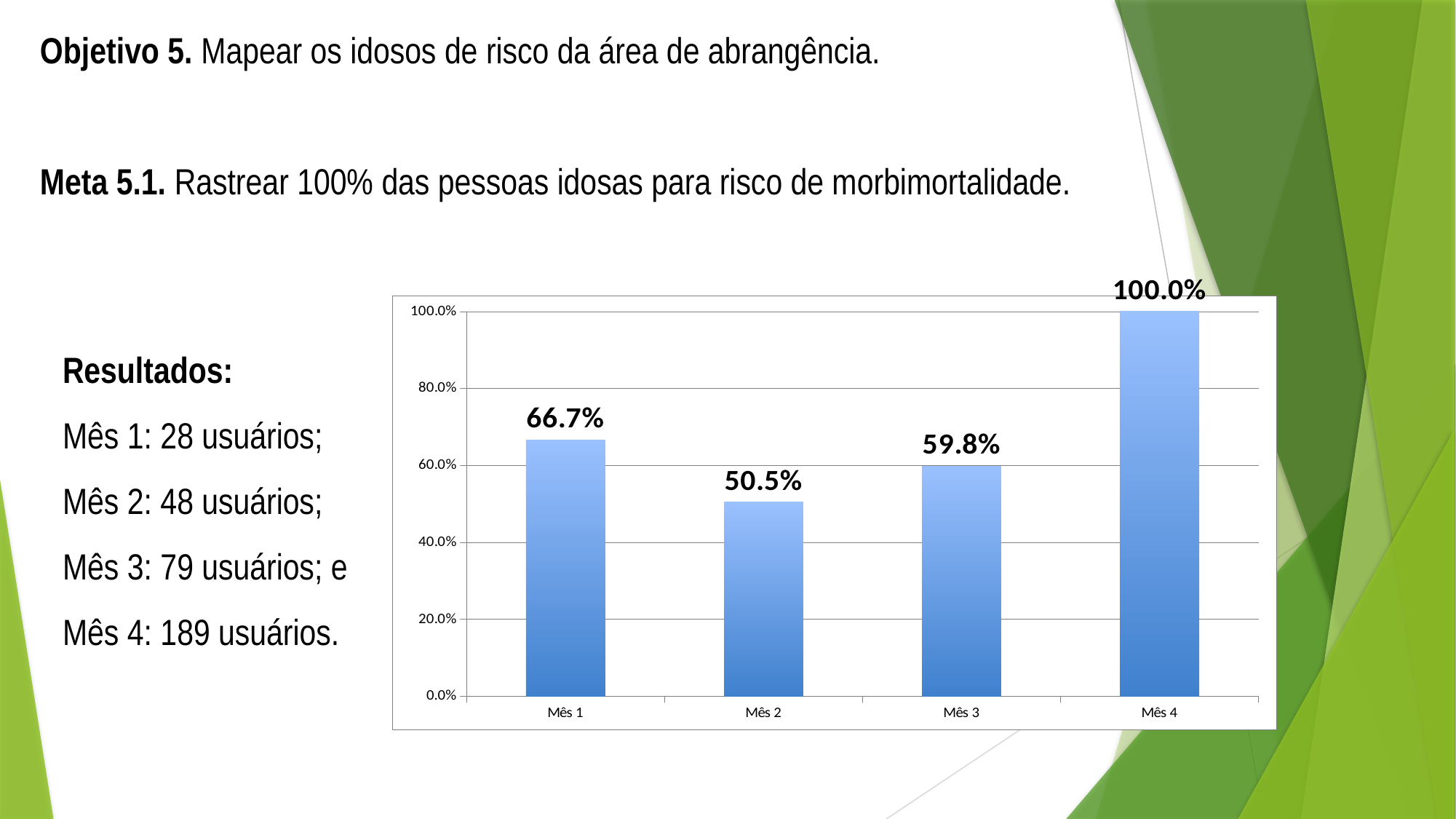
Is the value for Mês 2 greater or less than 60.0%? less Which month has the highest value? Mês 4 Which is larger, the value for Mês 1 or the value for Mês 3? Mês 1 What is the value for Mês 3? 59.8% Which month has the lowest value? Mês 2 What kind of chart is shown on the slide? bar chart How many months are shown on the x axis? 4 What is the value for Mês 2? 50.5% What is the value for Mês 4? 100.0% What is the value for Mês 1? 66.7% What is the difference between the values for Mês 3 and Mês 2? 9.3% What is the difference between the values for Mês 4 and Mês 1? 33.3%